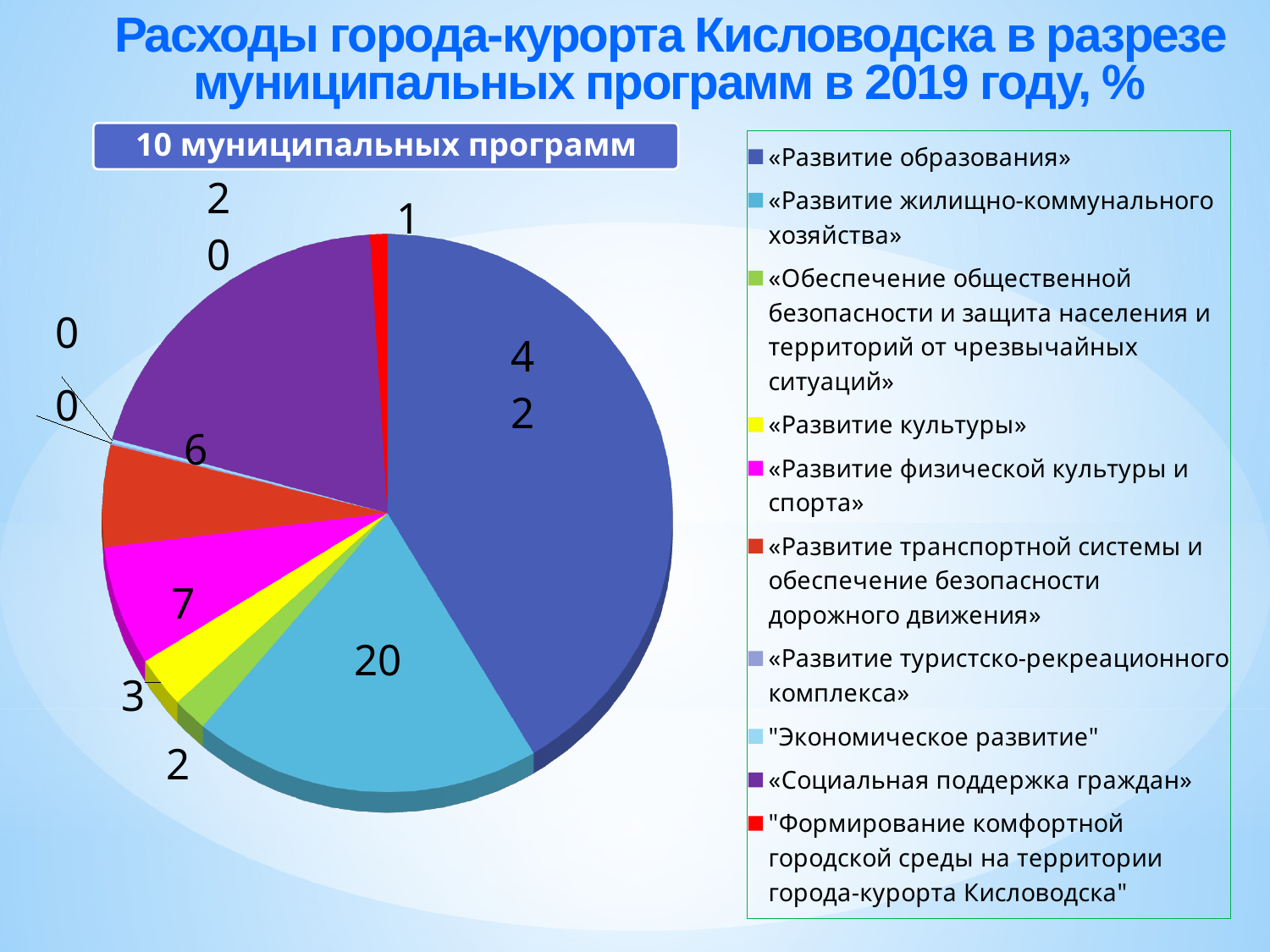
How many municipal programs (slices) does the pie chart show? 10 Which program has the largest share of expenditures in the pie chart? «Развитие образования» What is the difference between the shares of «Развитие образования» and «Социальная поддержка граждан»? 22 What percentage share does «Развитие жилищно-коммунального хозяйства» have? 20 Which is larger: the share for «Развитие физической культуры и спорта» or for «Развитие транспортной системы и обеспечение безопасности дорожного движения»? «Развитие физической культуры и спорта» What kind of chart is shown on the slide? pie chart What value is shown for «Развитие физической культуры и спорта»? 7 What percentage share does «Развитие образования» have in the pie chart? 42 What value is shown for «Развитие транспортной системы и обеспечение безопасности дорожного движения»? 6 What value is shown for «Развитие культуры»? 3 What value is shown for "Формирование комфортной городской среды на территории города-курорта Кисловодска"? 1 What does the text box above the pie chart say? 10 муниципальных программ